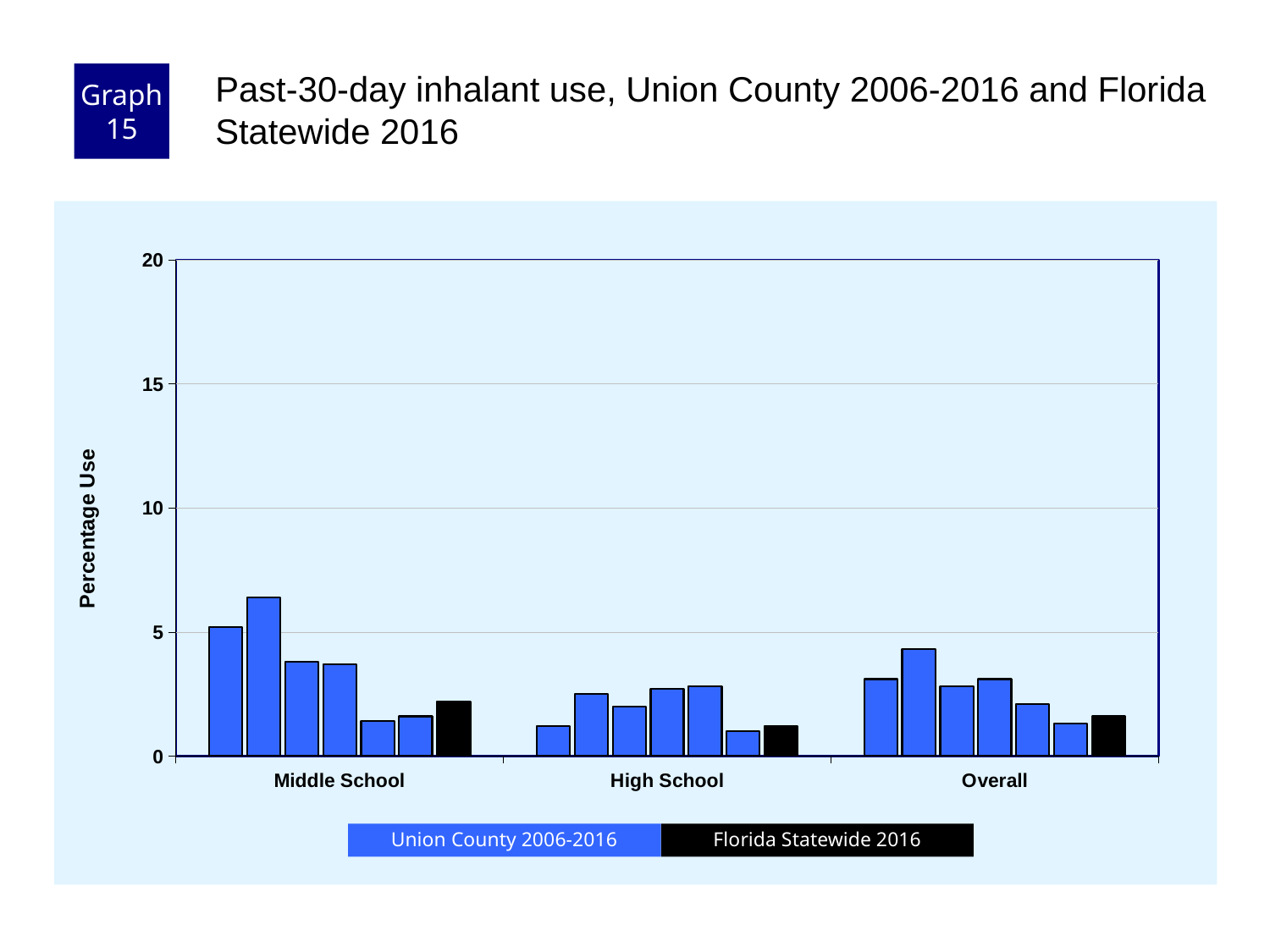
What is the label of the y axis? Percentage Use How many category groups are shown along the x axis? 3 Is the Florida Statewide 2016 value for Middle School greater or less than 5? less Are all the bars in the High School group below 5? yes What colour are the Florida Statewide 2016 bars? black Which is larger: the Florida Statewide 2016 bar for Middle School or the Florida Statewide 2016 bar for High School? Middle School Which is larger: the tallest bar in the Middle School group or the tallest bar in the Overall group? Middle School Is the tallest Union County bar in the Middle School group greater or less than 5? greater What kind of chart is shown on the slide? bar chart Which category group contains the tallest bar in the chart? Middle School How many series does the legend list? 2